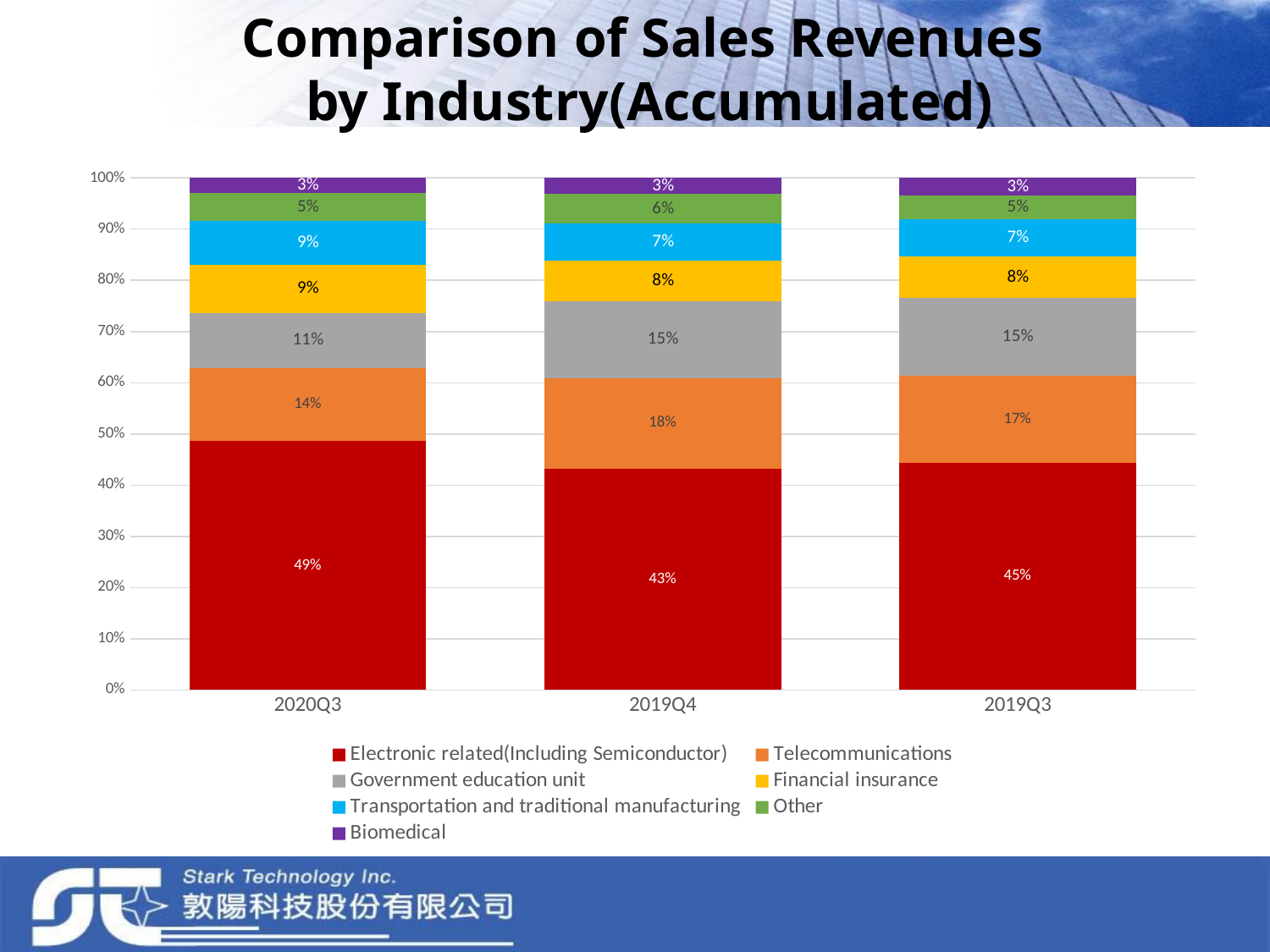
What is the value for Government education unit in 2019Q3? 15% What is the value for Telecommunications in 2019Q4? 18% What is the value for Financial insurance in 2020Q3? 9% In which period is the Electronic related(Including Semiconductor) share highest? 2020Q3 What is the value for Other in 2019Q4? 6% What kind of chart is shown on the slide? Stacked bar chart How many periods are shown on the x axis? 3 In which period is the Telecommunications share lowest? 2020Q3 How many series does the legend list? 7 What is the difference between the Electronic related(Including Semiconductor) share in 2020Q3 and in 2019Q4? 6% What is the value for Electronic related(Including Semiconductor) in 2020Q3? 49% Which is larger: the Government education unit share in 2020Q3 or in 2019Q4? 2019Q4